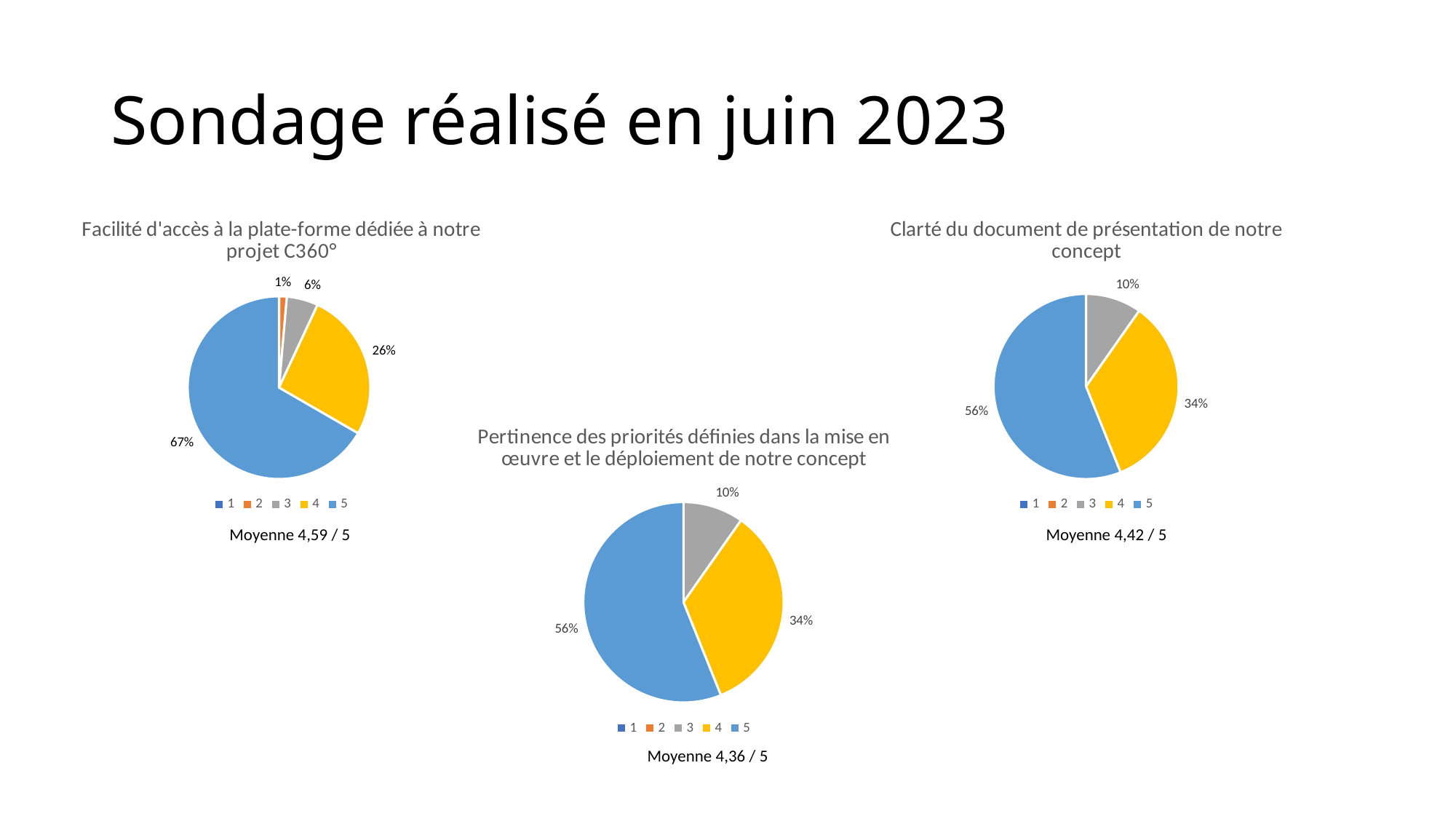
In the chart titled "Facilité d'accès à la plate-forme dédiée à notre projet C360°", which rating has the smallest slice? 2 In the chart titled "Pertinence des priorités définies dans la mise en œuvre et le déploiement de notre concept", which rating has the largest slice? 5 In the chart titled "Pertinence des priorités définies dans la mise en œuvre et le déploiement de notre concept", what percentage is shown for rating 5? 56% In the chart titled "Clarté du document de présentation de notre concept", what percentage is shown for rating 4? 34% In the chart titled "Facilité d'accès à la plate-forme dédiée à notre projet C360°", what percentage is shown for rating 3? 6% In the chart titled "Facilité d'accès à la plate-forme dédiée à notre projet C360°", what share of the pie does rating 5 take? 67% How many entries does the legend list in the chart titled "Clarté du document de présentation de notre concept"? 5 In the chart titled "Facilité d'accès à la plate-forme dédiée à notre projet C360°", what is the difference between the shares for rating 5 and rating 4? 41% In the chart titled "Facilité d'accès à la plate-forme dédiée à notre projet C360°", what percentage is shown for rating 4? 26% What kind of chart is the chart titled "Facilité d'accès à la plate-forme dédiée à notre projet C360°"? Pie chart In the chart titled "Clarté du document de présentation de notre concept", which is larger, the slice for rating 3 or the slice for rating 4? 4 In the chart titled "Pertinence des priorités définies dans la mise en œuvre et le déploiement de notre concept", what is the difference between the shares for rating 4 and rating 3? 24%